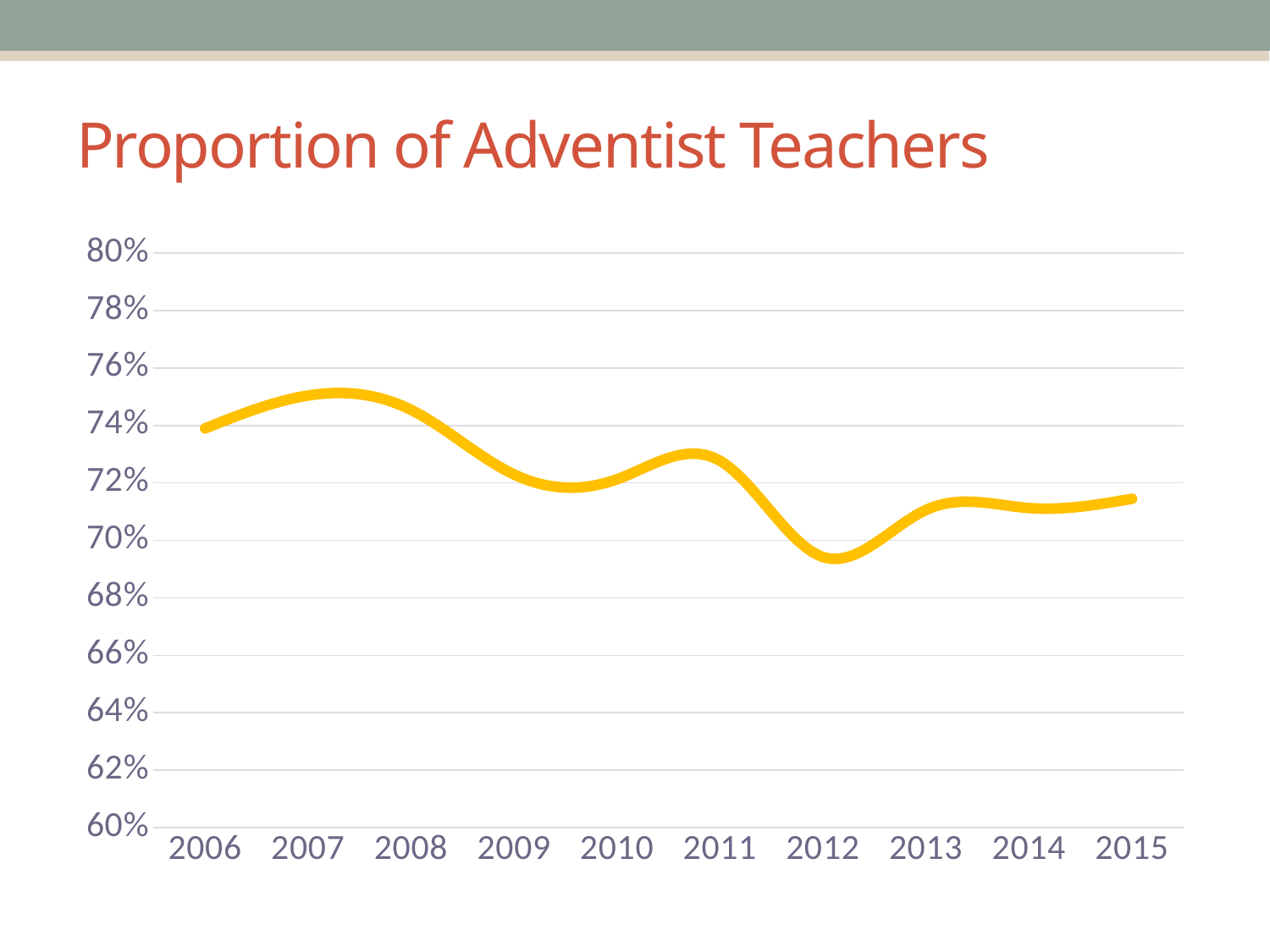
Which year has the highest proportion of Adventist teachers? 2007 Is the value for 2015 greater or less than 74%? less Which year has a higher proportion, 2007 or 2012? 2007 How many years are plotted along the x axis? 10 What is the title of the chart? Proportion of Adventist Teachers What kind of chart is shown on the slide? line chart Which year has the lowest proportion of Adventist teachers? 2012 Is the value for 2006 greater or less than 72%? greater Which year has a higher proportion, 2006 or 2013? 2006 Is the value for 2007 greater or less than 74%? greater Overall, does the proportion of Adventist teachers rise or fall from 2006 to 2015? fall